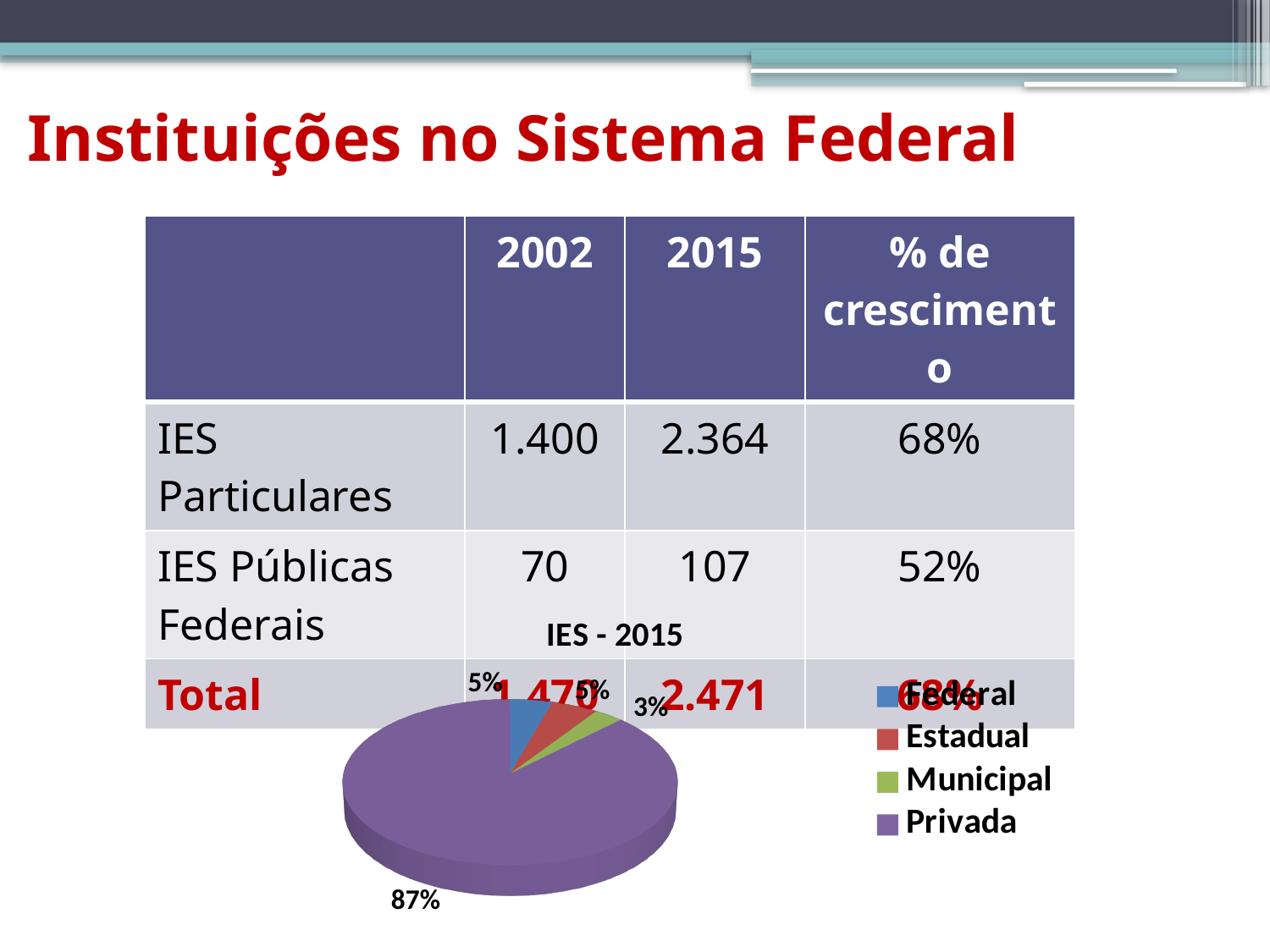
What is the value shown for Federal in the pie chart? 5% Which is larger in the pie chart, Privada or Federal? Privada Which category has the largest slice in the pie chart? Privada What share of the pie does Privada represent? 87% What kind of chart is shown on the slide? pie chart How many entries does the legend of the pie chart list? 4 What is the difference between the Privada share and the Municipal share in the pie chart? 84% How many slices does the pie chart have? 4 What is the value shown for Municipal in the pie chart? 3% Which category has the smallest slice in the pie chart? Municipal What is the title of the pie chart? IES - 2015 What colour is the Privada slice in the pie chart? purple